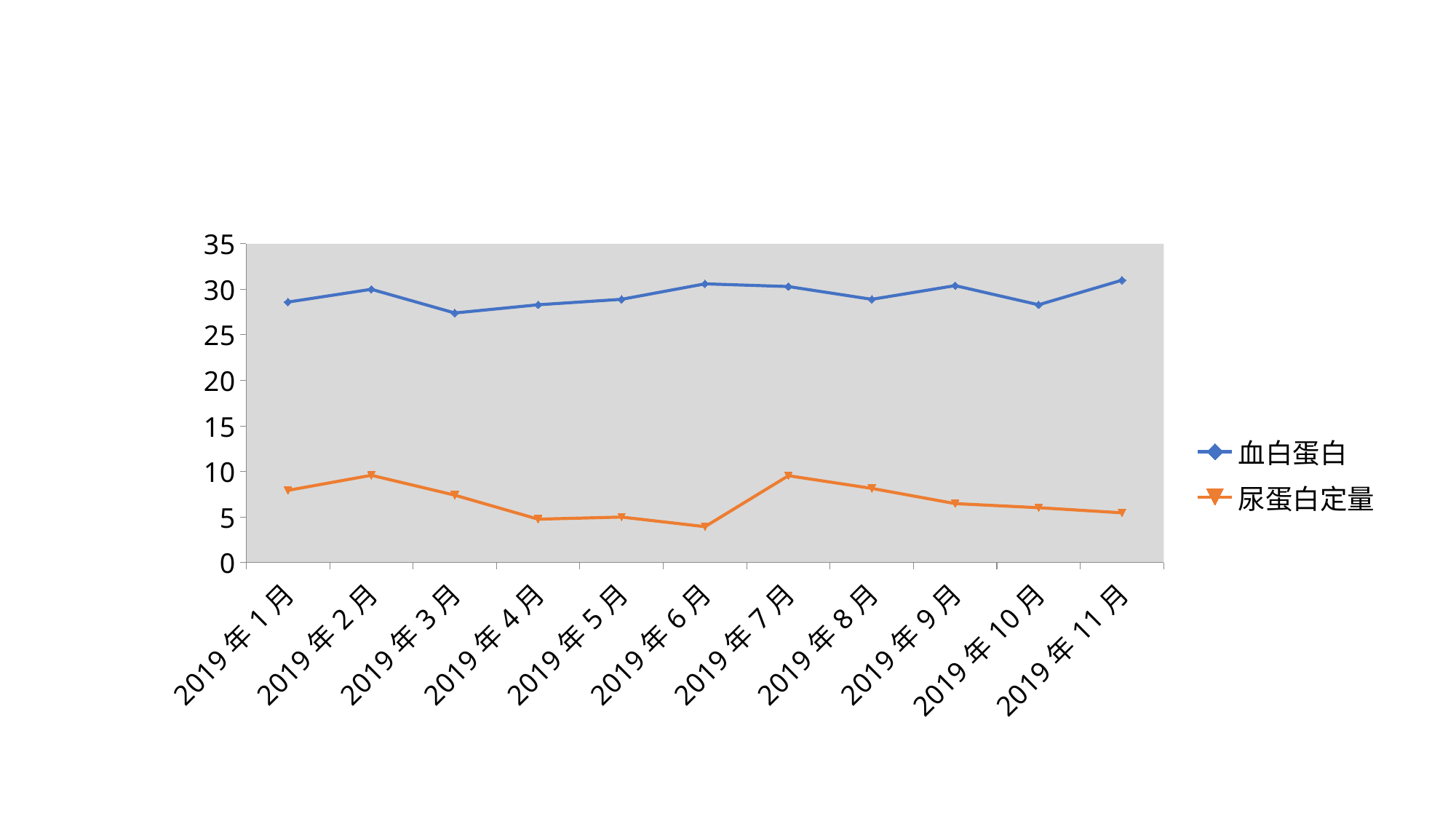
Is the value of 血白蛋白 for 2019年1月 greater or less than 25? greater Is the value of 血白蛋白 for 2019年3月 greater or less than 30? less What kind of chart is shown on the slide? line chart Which series is plotted higher on the chart, 血白蛋白 or 尿蛋白定量? 血白蛋白 In which month is 血白蛋白 at its lowest? 2019年3月 What colour is the 尿蛋白定量 line? orange In which month is 尿蛋白定量 at its lowest? 2019年6月 Is the value of 尿蛋白定量 for 2019年1月 greater or less than 5? greater Does 尿蛋白定量 rise or fall from 2019年7月 to 2019年11月? fall How many series does the legend list? 2 How many months are plotted along the x axis? 11